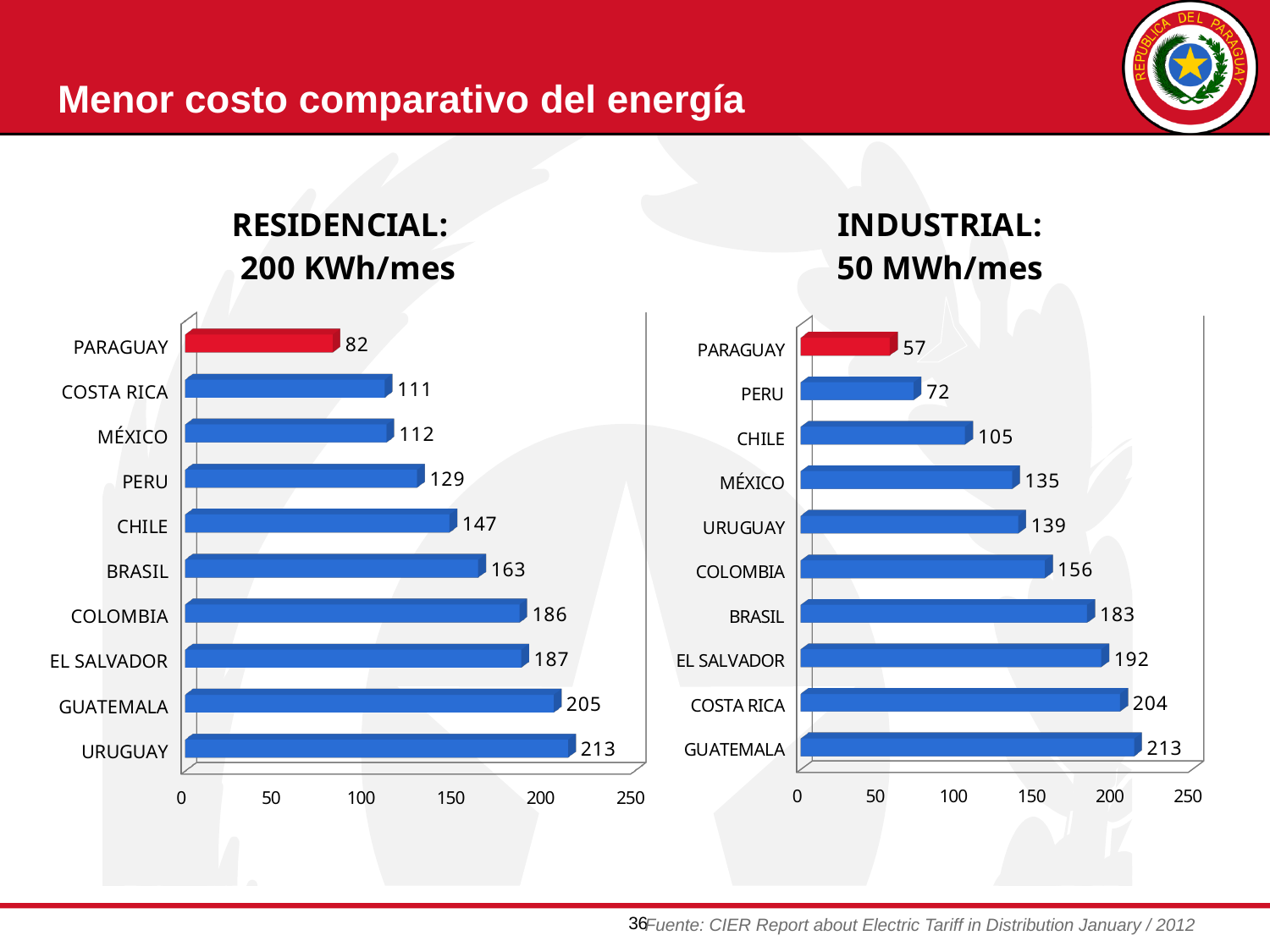
In the INDUSTRIAL: 50 MWh/mes chart, what is the difference between the values for COSTA RICA and PERU? 132 In the RESIDENCIAL: 200 KWh/mes chart, what is the value for COLOMBIA? 186 What kind of chart is the RESIDENCIAL: 200 KWh/mes chart? Bar chart In the INDUSTRIAL: 50 MWh/mes chart, what is the value for BRASIL? 183 In the RESIDENCIAL: 200 KWh/mes chart, is the value for BRASIL greater or less than 150? greater How many countries are shown in the INDUSTRIAL: 50 MWh/mes chart? 10 In the INDUSTRIAL: 50 MWh/mes chart, which country's bar is coloured red? PARAGUAY In the INDUSTRIAL: 50 MWh/mes chart, which is larger, the value for CHILE or the value for MÉXICO? MÉXICO In the RESIDENCIAL: 200 KWh/mes chart, what is the value for PARAGUAY? 82 In the RESIDENCIAL: 200 KWh/mes chart, what is the difference between the values for GUATEMALA and PARAGUAY? 123 In the INDUSTRIAL: 50 MWh/mes chart, which country has the lowest value? PARAGUAY In the RESIDENCIAL: 200 KWh/mes chart, which country has the highest value? URUGUAY